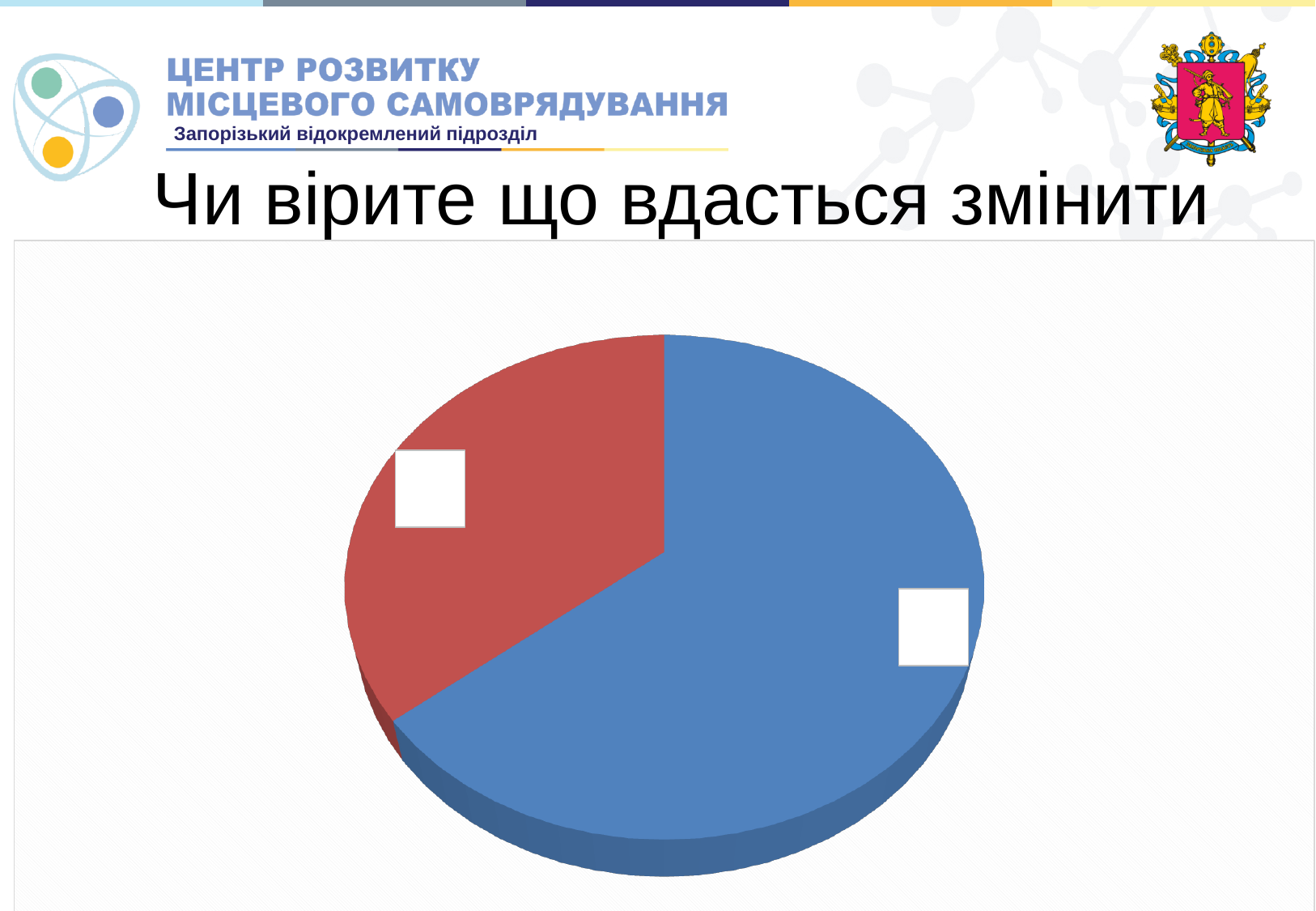
Does the blue slice cover more or less than half of the pie chart? more Which slice of the pie chart is larger, the blue one or the red one? the blue one Which colour slice takes up the largest share of the pie chart? blue How many slices does the pie chart have? 2 Which colour slice takes up the smallest share of the pie chart? red What two colours are used for the slices of the pie chart? blue and red What is the title shown above the pie chart? Чи вірите що вдасться змінити What kind of chart is shown on the slide? pie chart